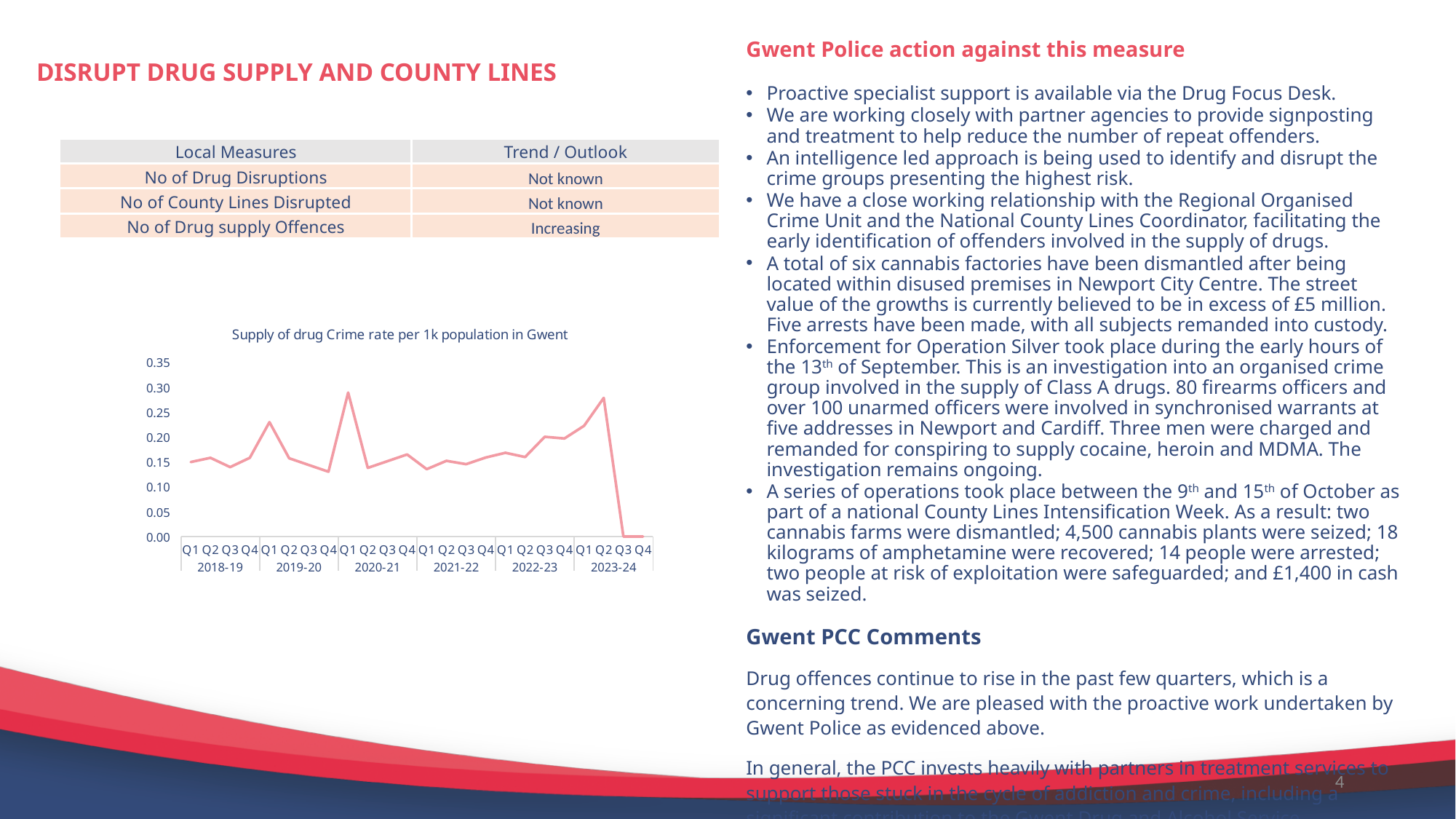
Is the value for Q3 2019-20 greater or less than 0.20? less Which is larger, the value for Q4 2019-20 or the value for Q1 2020-21? Q1 2020-21 How many quarterly data points are plotted on the chart? 24 How many financial years are shown along the x axis of the chart? 6 Is the value for Q1 2020-21 greater or less than 0.25? greater Does the line rise or fall between Q2 2023-24 and Q3 2023-24? fall Is the value for Q1 2021-22 greater or less than 0.20? less What value does the line show for Q4 2023-24? 0.00 What kind of chart is shown on the slide? line chart What is the title of the chart on the slide? Supply of drug Crime rate per 1k population in Gwent What is the highest value shown on the chart's y axis? 0.35